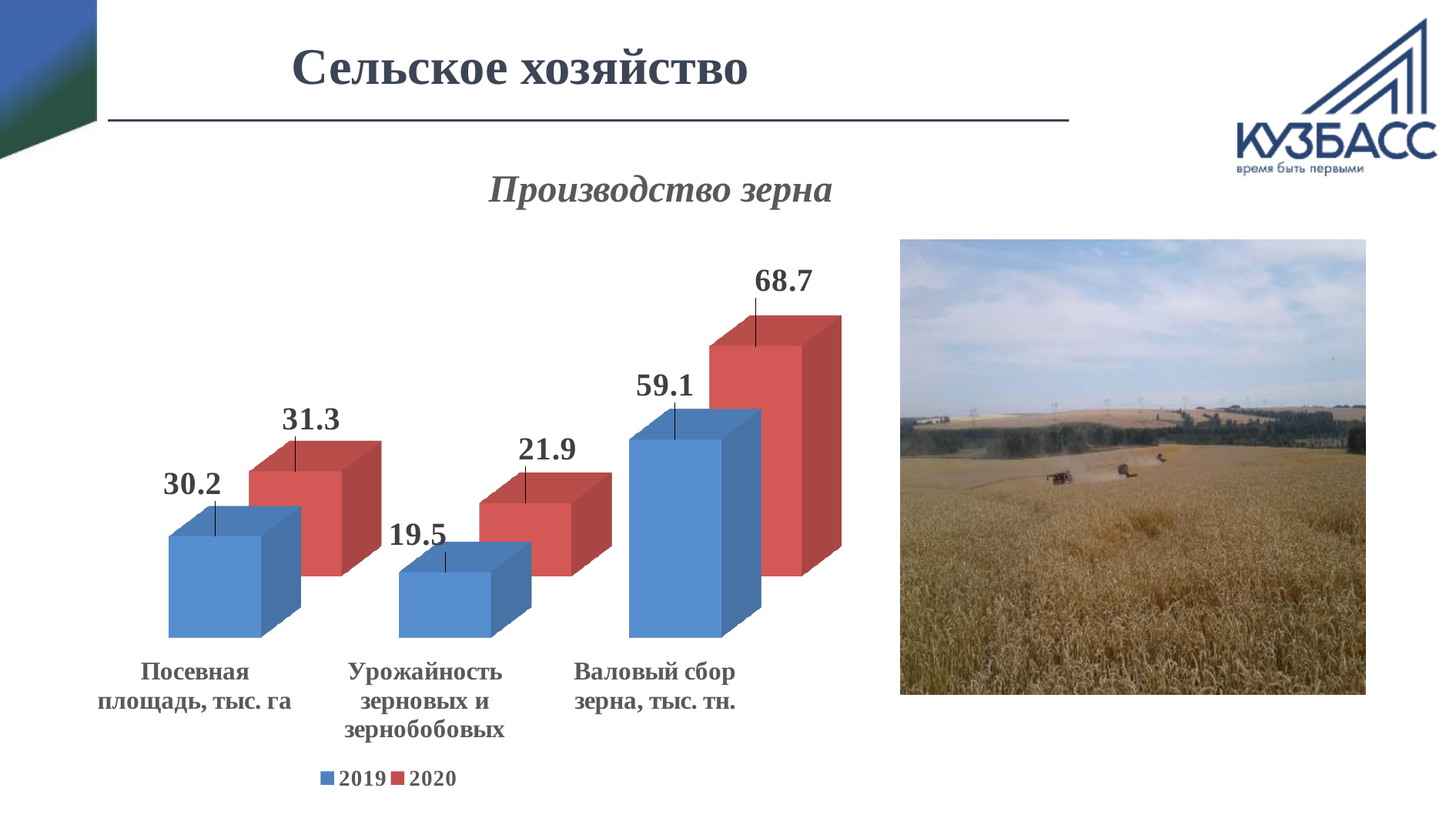
How many series does the legend list? 2 What is the 2019 value for Посевная площадь, тыс. га? 30.2 How many categories are shown on the x axis? 3 What is the difference between the 2020 and 2019 values for Посевная площадь, тыс. га? 1.1 What is the difference between the 2020 and 2019 values for Валовый сбор зерна, тыс. тн.? 9.6 What is the title of the chart? Производство зерна What kind of chart is shown on the slide? Bar chart Which category has the highest 2020 value? Валовый сбор зерна, тыс. тн. What is the 2020 value for Валовый сбор зерна, тыс. тн.? 68.7 What is the 2020 value for Урожайность зерновых и зернобобовых? 21.9 Which category has the lowest 2019 value? Урожайность зерновых и зернобобовых Which is larger: the 2019 value for Урожайность зерновых и зернобобовых or the 2020 value for Урожайность зерновых и зернобобовых? 2020